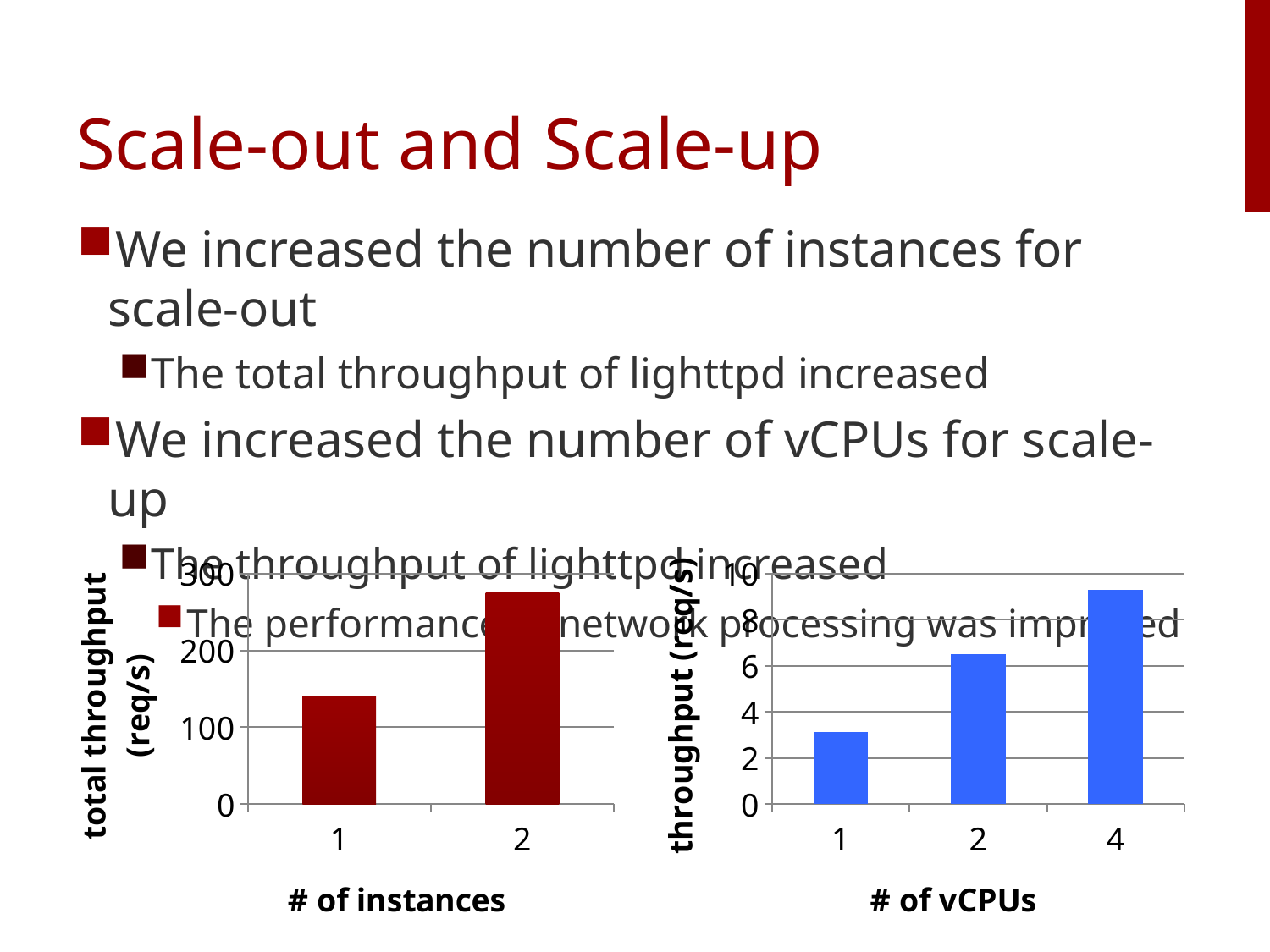
In the right chart (# of vCPUs), is the throughput for 4 vCPUs greater or less than 8? greater In the right chart (# of vCPUs), which number of vCPUs has the lowest throughput? 1 In the left chart (# of instances), which number of instances has the highest total throughput? 2 In the right chart (# of vCPUs), which number of vCPUs has the highest throughput? 4 In the left chart (# of instances), is the total throughput for 1 instance greater or less than 100? greater In the left chart (# of instances), how many bars are plotted? 2 In the left chart (# of instances), is the total throughput for 2 instances greater or less than 200? greater What kind of chart is the left chart (# of instances)? bar chart In the left chart (# of instances), which number of instances has the lowest total throughput? 1 In the right chart (# of vCPUs), how many bars are plotted? 3 In the right chart (# of vCPUs), does throughput rise or fall as the number of vCPUs increases? rise